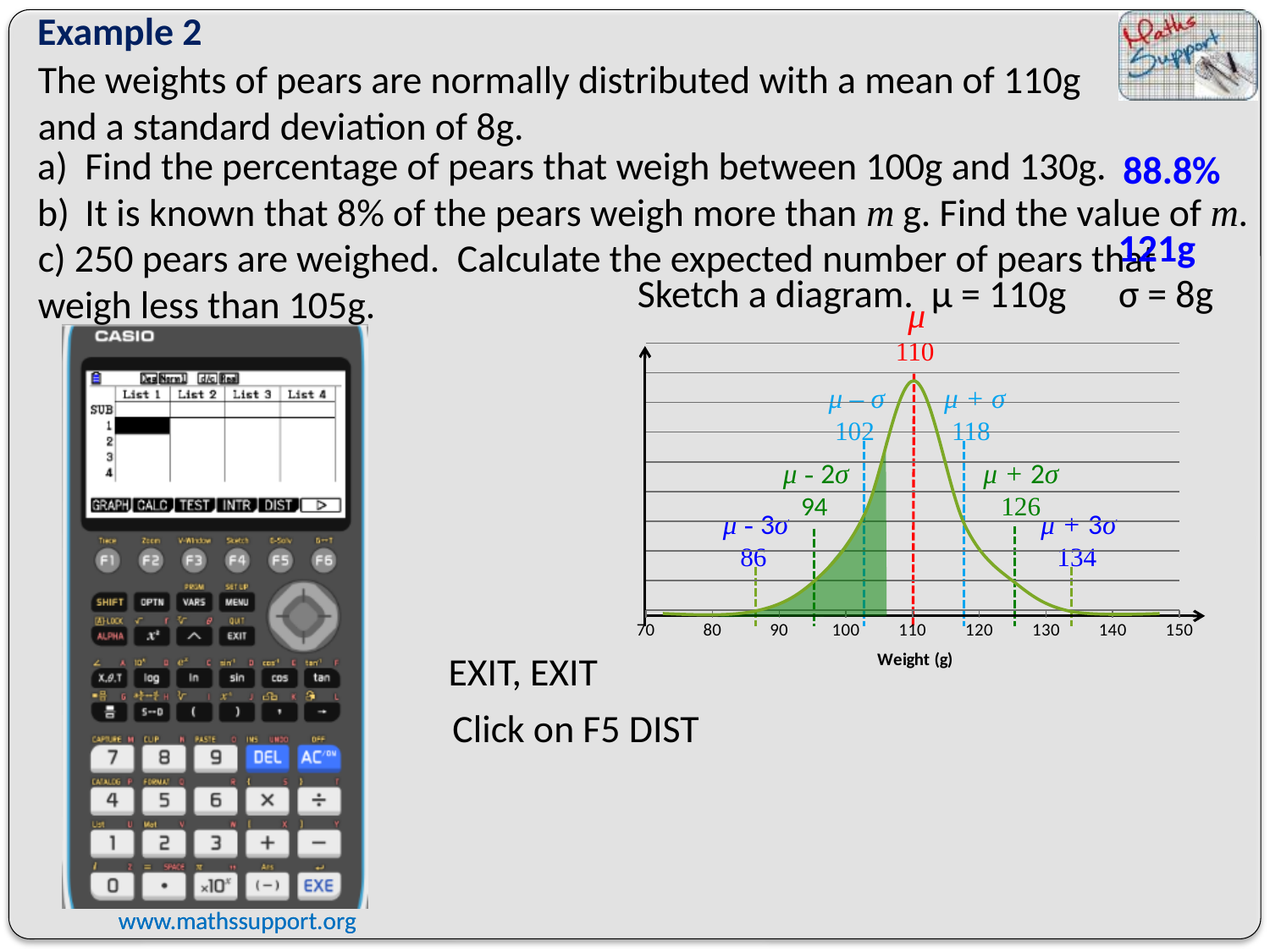
On the normal distribution sketch, what value is labelled at μ + σ? 118 On the normal distribution sketch, how many labelled points (μ and the σ markers) are marked along the curve? 7 What kind of chart is the sketch on the right of the slide? Line chart (normal distribution curve) On the normal distribution sketch, which is larger: the value at μ + 2σ or the value at μ + σ? μ + 2σ What is the title of the horizontal axis on the normal distribution sketch? Weight (g) On the normal distribution sketch, what value is labelled at μ + 3σ? 134 On the normal distribution sketch, what value is labelled at μ − 2σ? 94 On the normal distribution sketch, what value is labelled at the mean μ? 110 On the normal distribution sketch, what is the difference between the values labelled at μ + σ and μ − σ? 16 On the normal distribution sketch, what value is labelled at μ − 3σ? 86 On the normal distribution sketch, what value is labelled at μ − σ? 102 On the normal distribution sketch, what value is labelled at μ + 2σ? 126